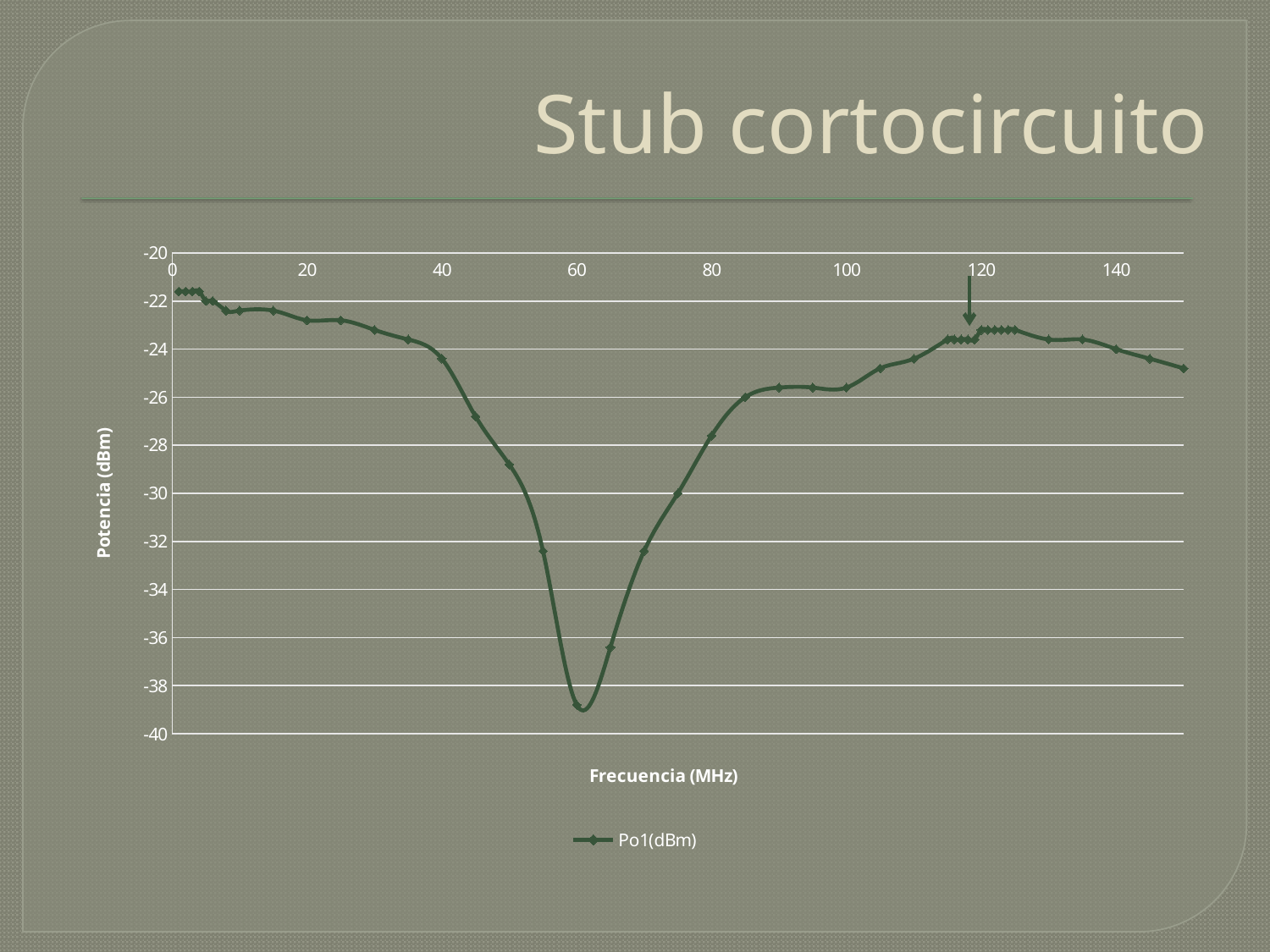
Is the value for Po1(dBm) at 40 MHz greater or less than -26? greater What is the name of the series shown in the legend? Po1(dBm) Is the value for Po1(dBm) at 80 MHz greater or less than -30? greater What kind of chart is shown on the slide? line chart What is the title of the x axis? Frecuencia (MHz) How many series does the legend list? 1 Is the value for Po1(dBm) at 100 MHz greater or less than -28? greater Between 40 MHz and 60 MHz, does the Po1(dBm) value rise or fall? fall Between 60 MHz and 80 MHz, does the Po1(dBm) value rise or fall? rise Near which x-axis tick does the Po1(dBm) curve reach its lowest value? 60